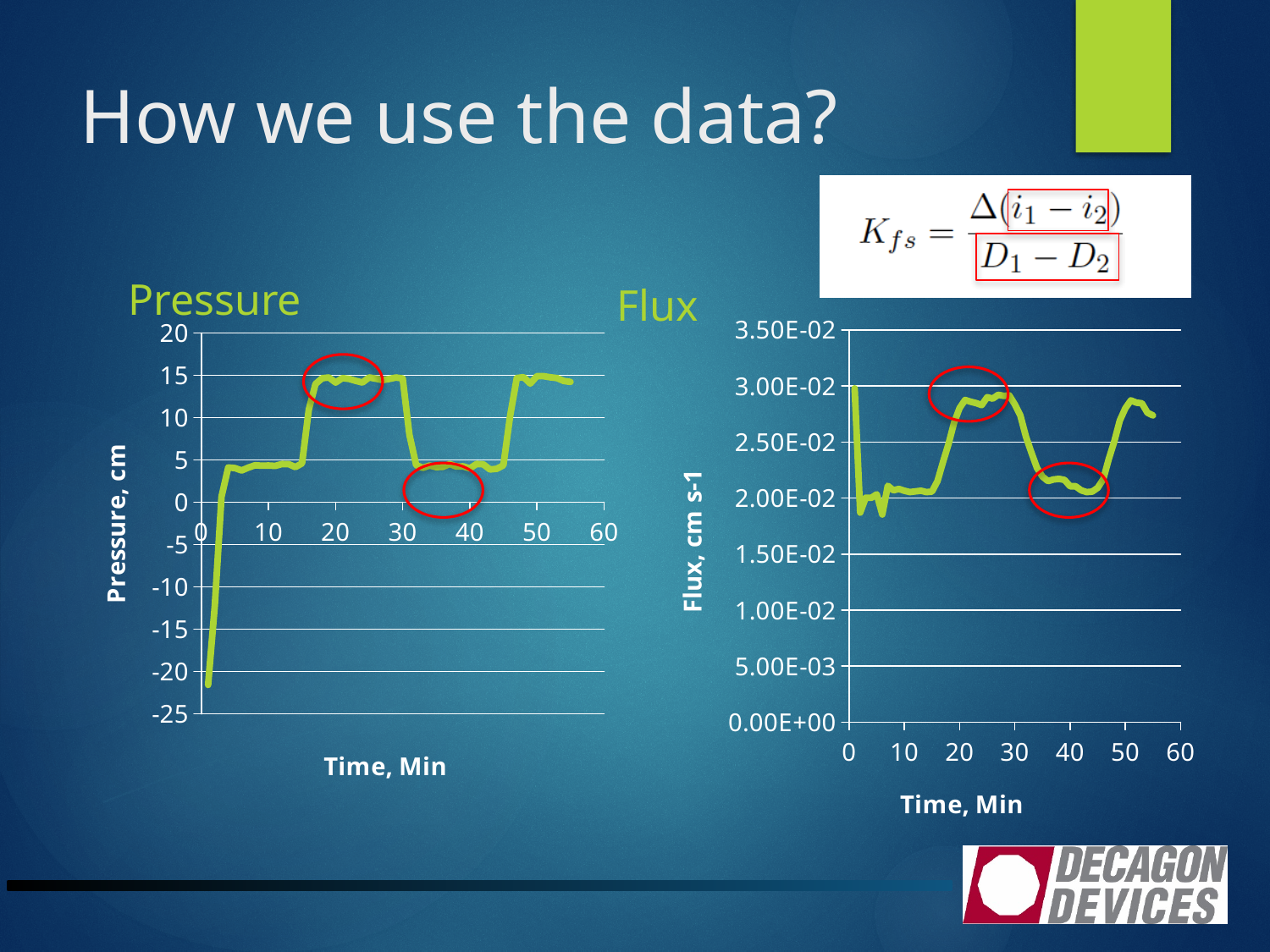
What kind of chart is the Flux chart? line chart On the Pressure chart, is the pressure at 40 minutes greater or less than 10? less On the Pressure chart, what is the label of the vertical axis? Pressure, cm On the Pressure chart, is the pressure at 0 minutes greater or less than 0? less On the Flux chart, does the flux rise or fall between 45 and 50 minutes? rise On the Pressure chart, does the pressure rise or fall between 30 and 35 minutes? fall On the Flux chart, is the flux at 10 minutes greater or less than 2.50E-02? less On the Flux chart, what is the label of the horizontal axis? Time, Min What kind of chart is the Pressure chart? line chart